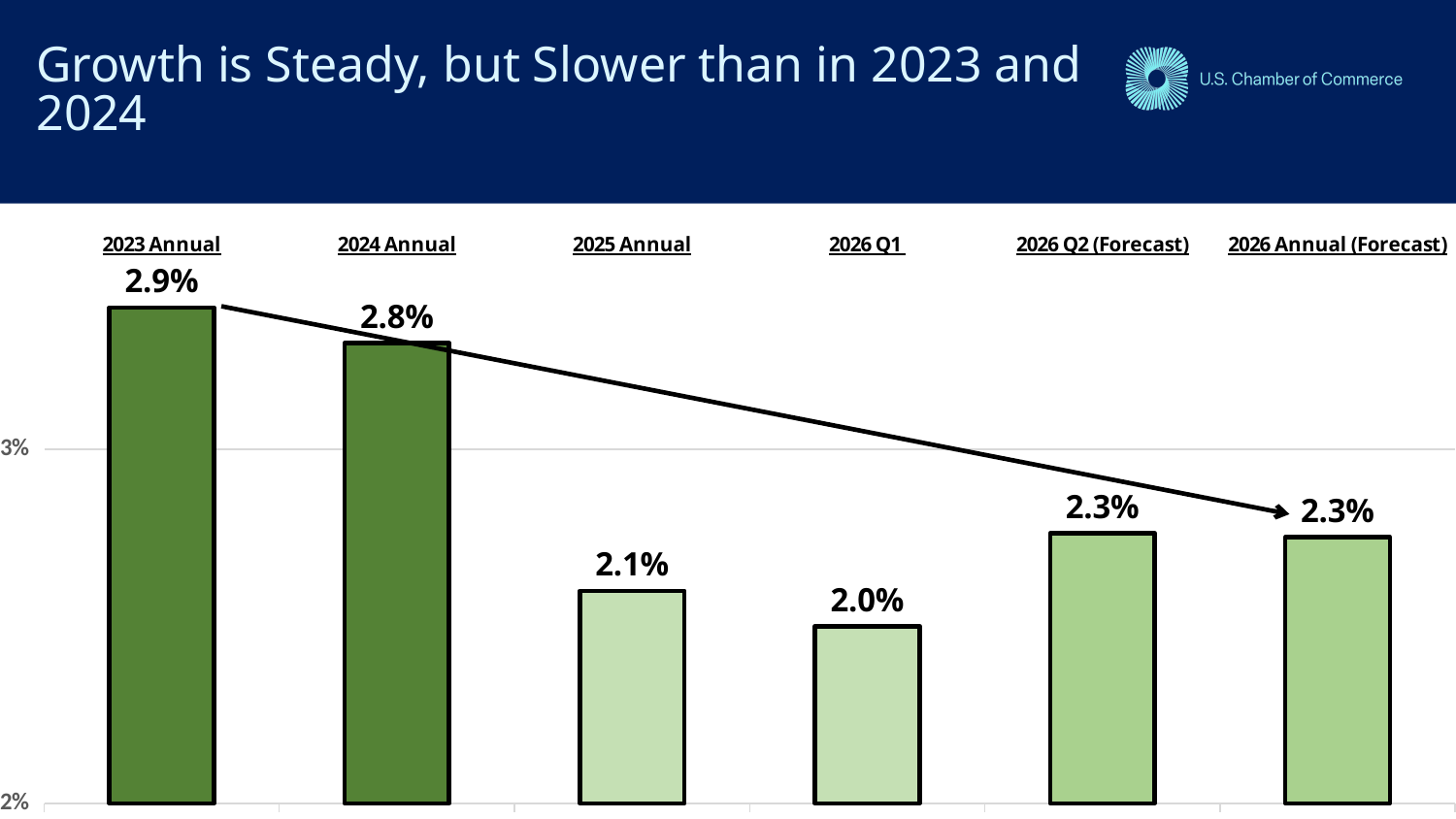
What is the value for 2025 Annual? 2.1% Which category has the highest value? 2023 Annual How many categories are shown on the chart? 6 What is the value for 2023 Annual? 2.9% Is the value for 2026 Q1 greater or less than 3%? less What is the title of the slide containing the chart? Growth is Steady, but Slower than in 2023 and 2024 What is the value for 2026 Q2 (Forecast)? 2.3% What kind of chart is shown on the slide? bar chart What is the value for 2026 Q1? 2.0% Which is larger, the value for 2024 Annual or the value for 2025 Annual? 2024 Annual What is the difference between the 2023 Annual value and the 2026 Annual (Forecast) value? 0.6% Which category has the lowest value? 2026 Q1